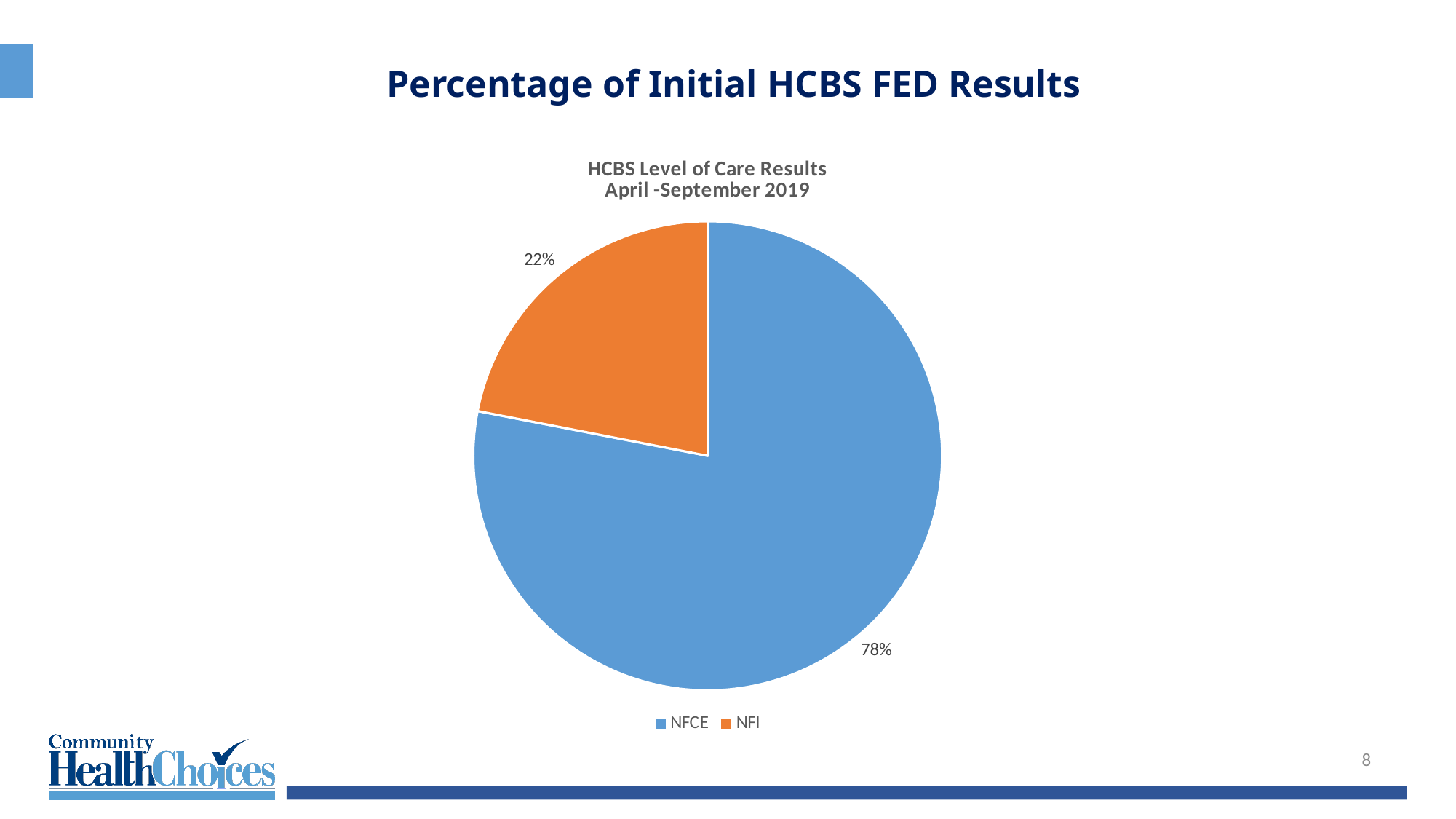
Which category has the smallest share of the pie? NFI How many entries does the legend list? 2 What type of chart is shown on the slide? Pie chart What is the difference in percentage points between the NFCE and NFI shares? 56 How many categories does the pie chart show? 2 Which category has the largest share of the pie? NFCE What share of the pie does the NFCE slice represent? 78% What is the title of the chart? HCBS Level of Care Results April -September 2019 What colour represents NFI in the pie chart? Orange Which is larger, the NFCE share or the NFI share? NFCE What percentage of HCBS Level of Care Results is NFCE? 78% What percentage of HCBS Level of Care Results is NFI? 22%